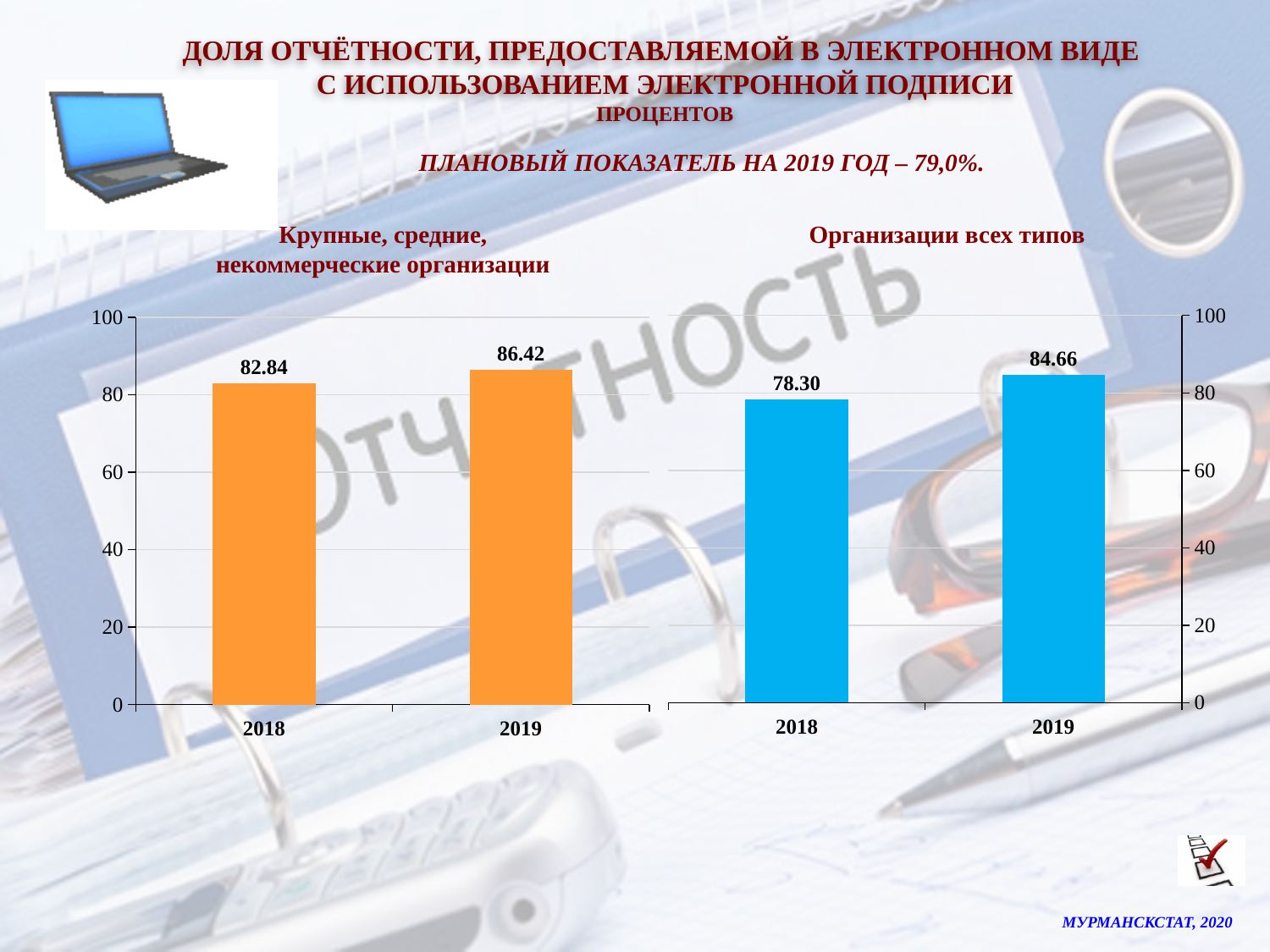
In the left chart (Крупные, средние, некоммерческие организации), what is the value for 2019? 86.42 In the left chart (Крупные, средние, некоммерческие организации), what is the difference between the 2019 and 2018 values? 3.58 What type of chart is used on this slide? Bar chart In the left chart (Крупные, средние, некоммерческие организации), which year has the lower value? 2018 In the right chart (Организации всех типов), what is the value for 2018? 78.30 In the right chart (Организации всех типов), what is the difference between the 2019 and 2018 values? 6.36 In the right chart (Организации всех типов), is the value for 2018 greater or less than 80? less How many bars does the left chart (Крупные, средние, некоммерческие организации) show? 2 In the left chart (Крупные, средние, некоммерческие организации), what is the value for 2018? 82.84 In the right chart (Организации всех типов), what is the value for 2019? 84.66 In the right chart (Организации всех типов), which year has the higher value? 2019 Which is larger: the 2019 value in the left chart or the 2019 value in the right chart? The 2019 value in the left chart (86.42)